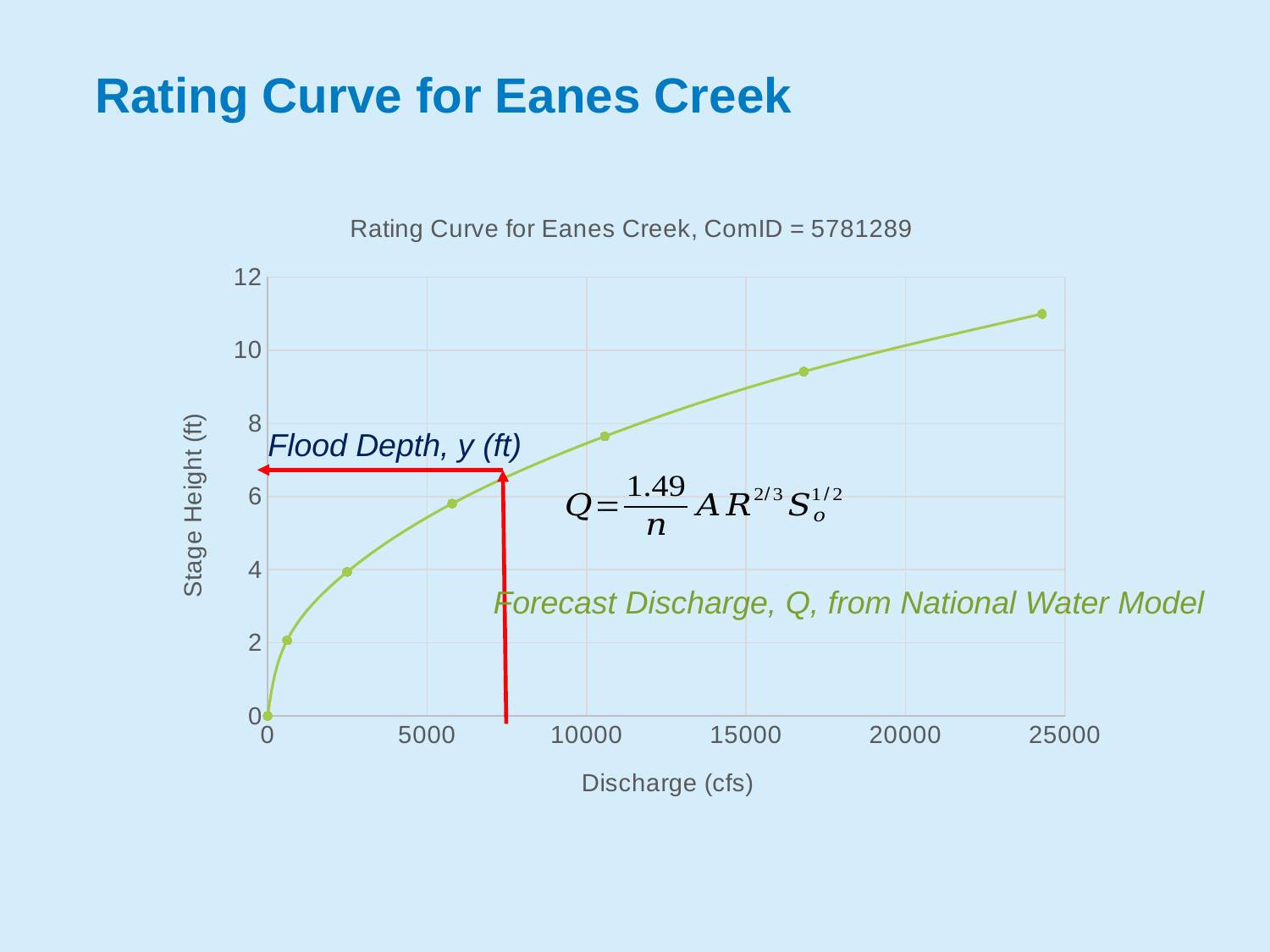
Is the stage height of the rightmost data point greater or less than 10? greater What is the title of the chart? Rating Curve for Eanes Creek, ComID = 5781289 What is the label of the y axis of the chart? Stage Height (ft) Is the stage height of the data point nearest 10000 cfs greater or less than 6? greater How many data points are plotted on the rating curve? 7 Which has the higher stage height: the leftmost data point or the rightmost data point? the rightmost data point Is the discharge of the point with the highest stage height greater or less than 25000? less What is the stage height at a discharge of 0 cfs? 0 What kind of chart is shown on the slide? line chart Does the stage height rise or fall as discharge increases along the x axis? rise